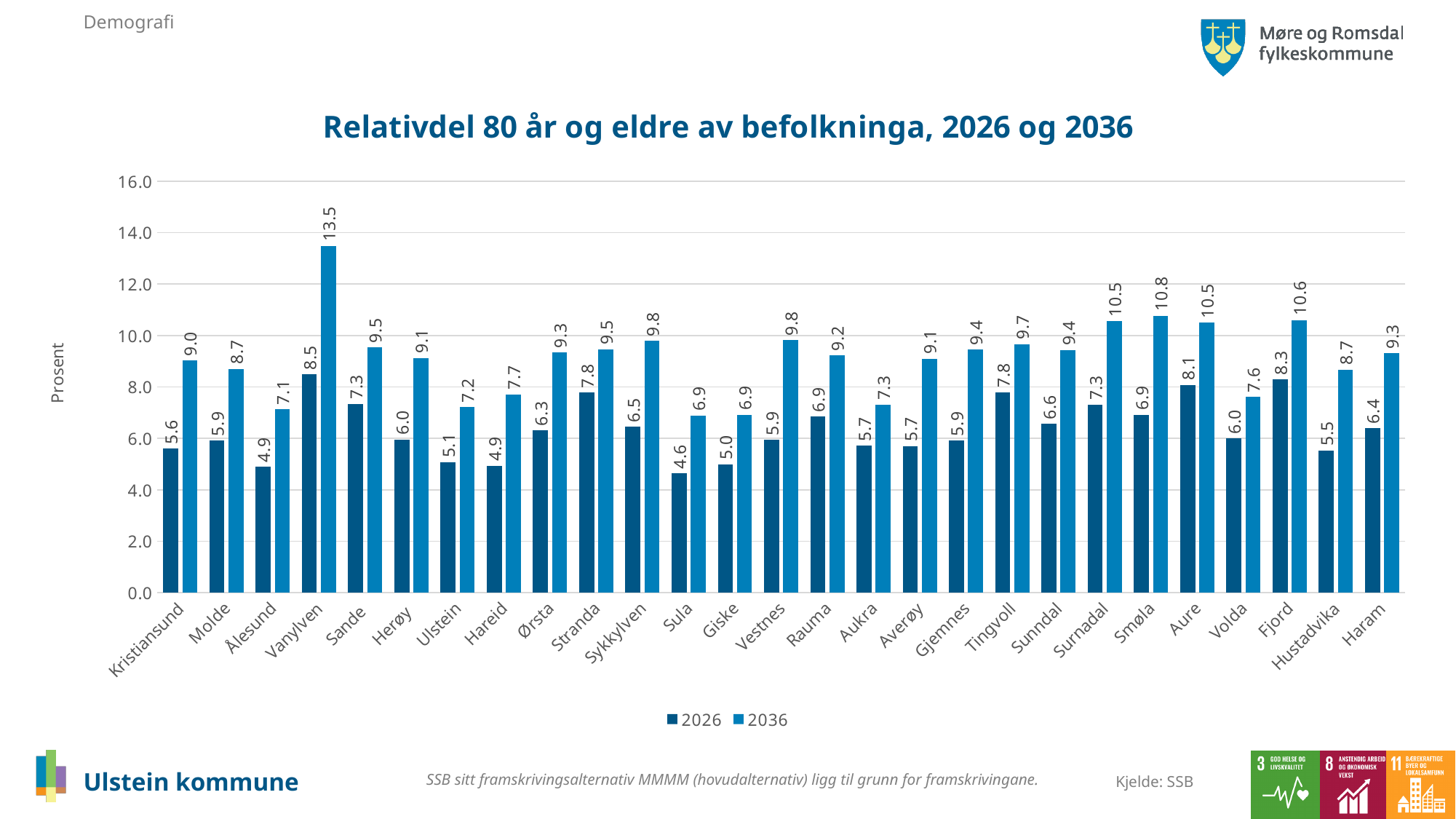
What is the difference between the 2036 values for Vanylven and Smøla? 2.7 What is the value for Vanylven in 2026? 8.5 Which municipality has the highest value in 2036? Vanylven How many municipalities are shown on the x axis? 27 What is the difference between the 2036 and 2026 values for Ulstein? 2.1 How many series does the legend list? 2 Which is larger, the 2026 value for Fjord or the 2026 value for Aure? Fjord What is the value for Hustadvika in 2026? 5.5 What is the value for Ulstein in 2036? 7.2 Is the 2036 value for Surnadal greater or less than 10.0? greater What kind of chart is shown on the slide? Bar chart Which municipality has the lowest value in 2026? Sula